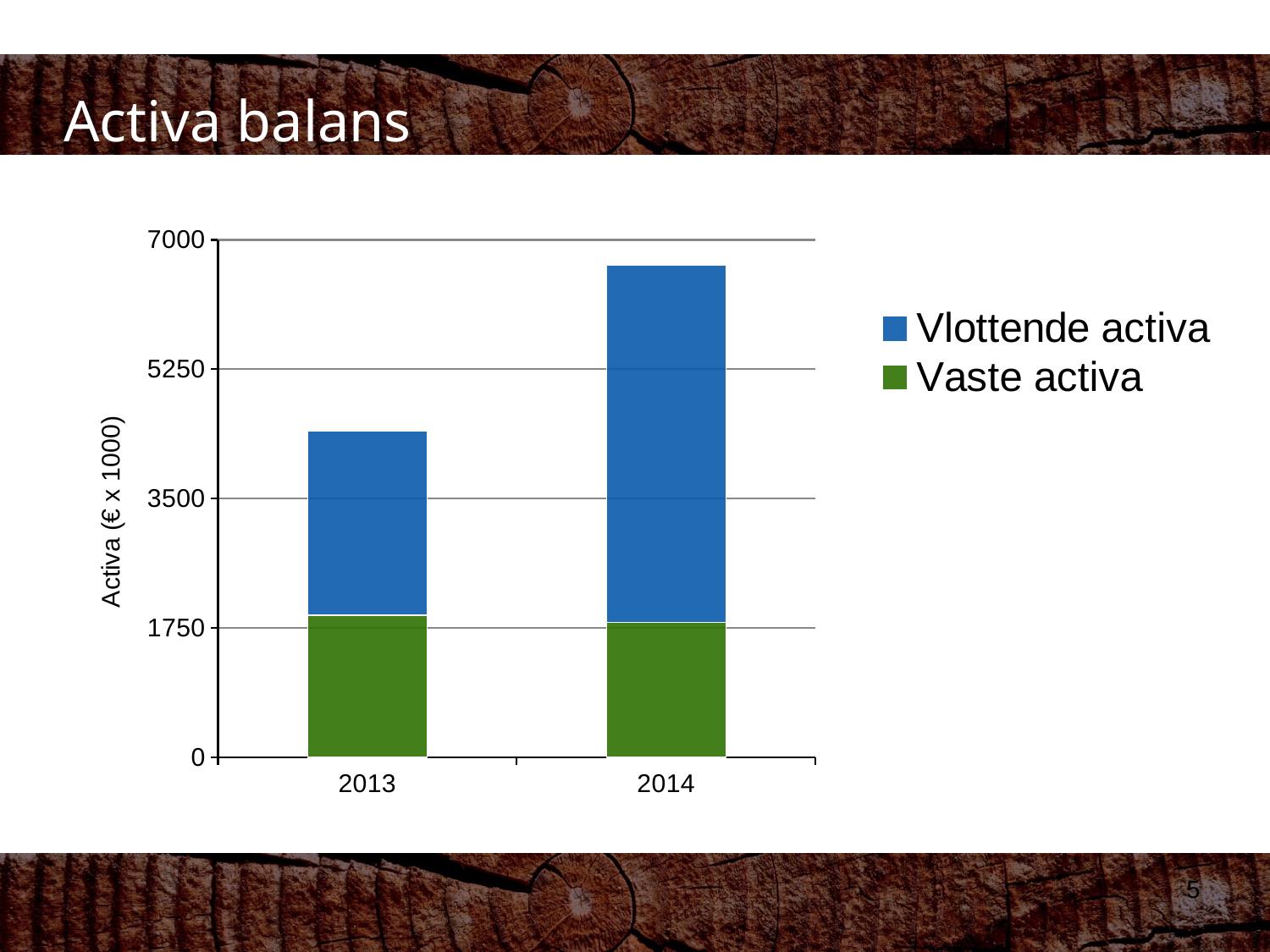
Is the total activa for 2014 greater or less than 7000? less Does the total activa rise or fall from 2013 to 2014? rise What is the label of the vertical axis of the chart? Activa (€ x 1000) Is the total activa for 2013 greater or less than 3500? greater Is the total activa for 2014 greater or less than 5250? greater What kind of chart is shown on the slide? Stacked bar chart Which year has the higher total activa bar, 2013 or 2014? 2014 How many years are shown on the x axis of the chart? 2 How many series does the chart legend list? 2 Which year has the lowest total activa? 2013 Which series are listed in the chart legend? Vlottende activa and Vaste activa